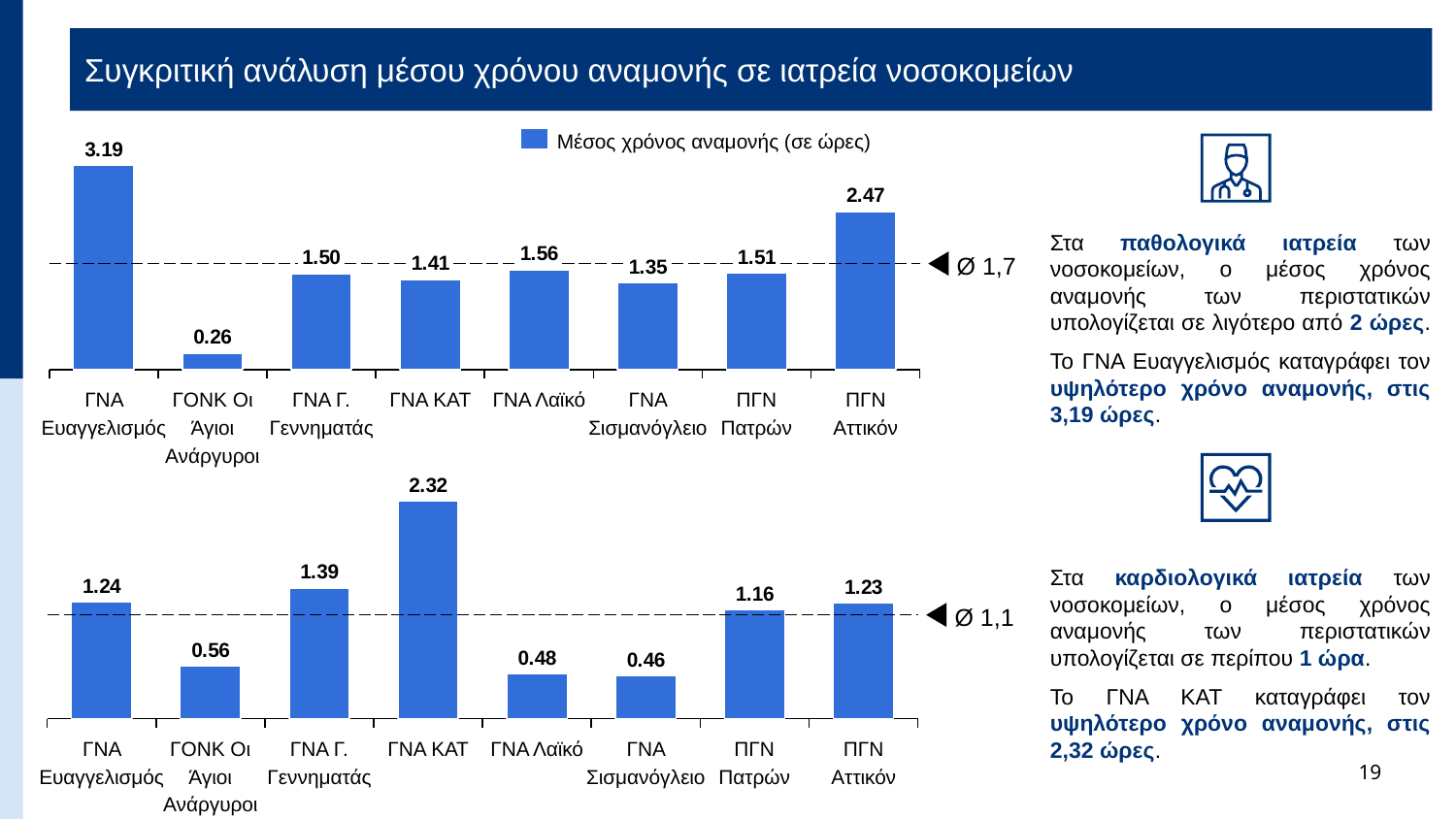
What type of chart is the bottom chart? Bar chart In the top chart, what is the difference between the values for ΠΓΝ Αττικόν and ΓΝΑ Λαϊκό? 0.91 In the bottom chart, which is larger, the value for ΓΝΑ Ευαγγελισμός or the value for ΠΓΝ Αττικόν? ΓΝΑ Ευαγγελισμός In the bottom chart, what is the difference between the values for ΓΝΑ ΚΑΤ and ΓΝΑ Γ. Γεννηματάς? 0.93 What is the legend entry shown above the top chart? Μέσος χρόνος αναμονής (σε ώρες) In the bottom chart, what is the value for ΓΝΑ Σισμανόγλειο? 0.46 In the top chart, what is the average waiting time for ΓΝΑ Ευαγγελισμός? 3.19 In the top chart, which hospital has the lowest average waiting time? ΓΟΝΚ Οι Άγιοι Ανάργυροι In the top chart, which is larger, the value for ΓΝΑ ΚΑΤ or the value for ΠΓΝ Πατρών? ΠΓΝ Πατρών In the top chart, how many hospitals are shown? 8 What value does the dashed average line in the top chart mark? Ø 1,7 In the bottom chart, which hospital has the highest average waiting time? ΓΝΑ ΚΑΤ